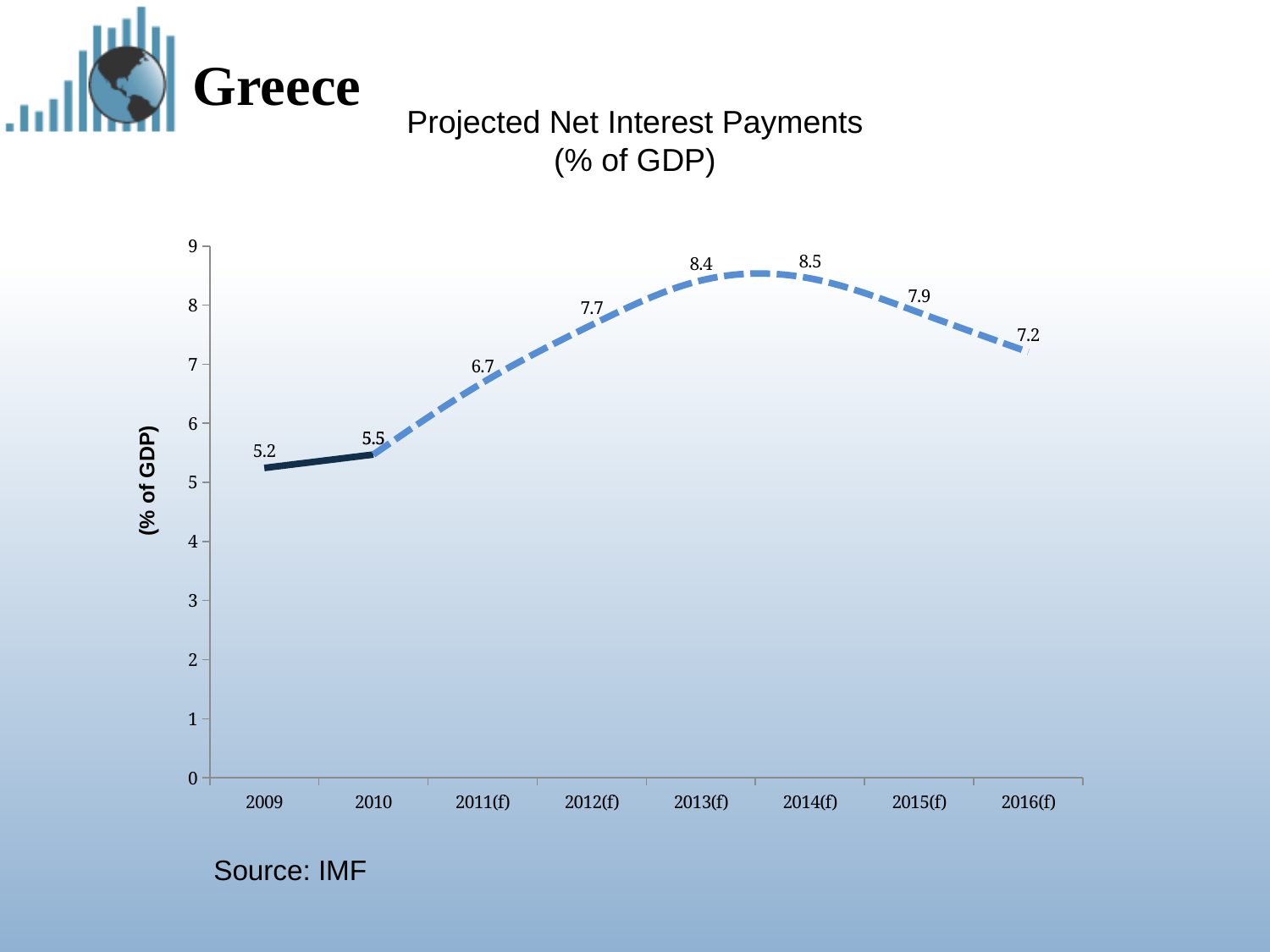
What is the value for 2009? 5.2 What is the value for 2016(f)? 7.2 Do the values rise or fall from 2009 to 2014(f)? Rise Which is larger, the value for 2012(f) or the value for 2015(f)? 2015(f) What kind of chart is shown on the slide? Line chart What is the title of the chart? Projected Net Interest Payments (% of GDP) How many years are shown on the x axis? 8 Which year has the lowest value on the chart? 2009 What is the difference between the values for 2014(f) and 2016(f)? 1.3 What is the difference between the values for 2011(f) and 2010? 1.2 What is the projected net interest payment for Greece in 2013(f)? 8.4 Which year has the highest projected net interest payment? 2014(f)